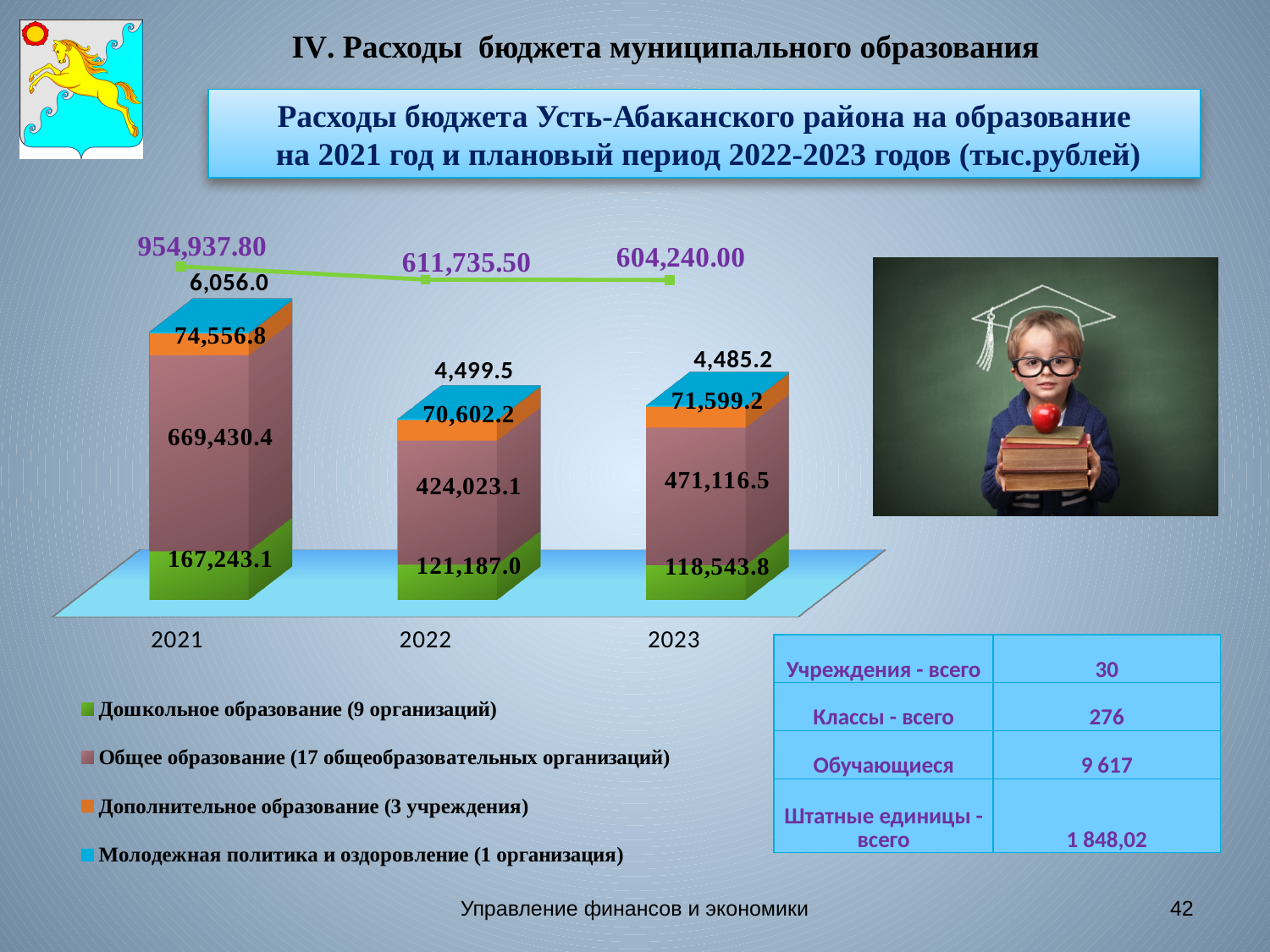
Which is larger: Дополнительное образование in 2021 or in 2022? 2021 What total value is shown above the bar for 2021? 954,937.80 What kind of chart is used to show the education expenditures? Stacked bar chart In which year is the value for Дошкольное образование the lowest? 2023 In which year is the value for Общее образование the highest? 2021 What is the value for Дошкольное образование in 2021? 167,243.1 How many years are shown on the x axis of the chart? 3 What is the value for Дополнительное образование in 2023? 71,599.2 What is the difference between the Общее образование values for 2023 and 2022? 47,093.4 How many series does the chart legend list? 4 What is the value for Молодежная политика и оздоровление in 2022? 4,499.5 What is the value for Общее образование in 2022? 424,023.1